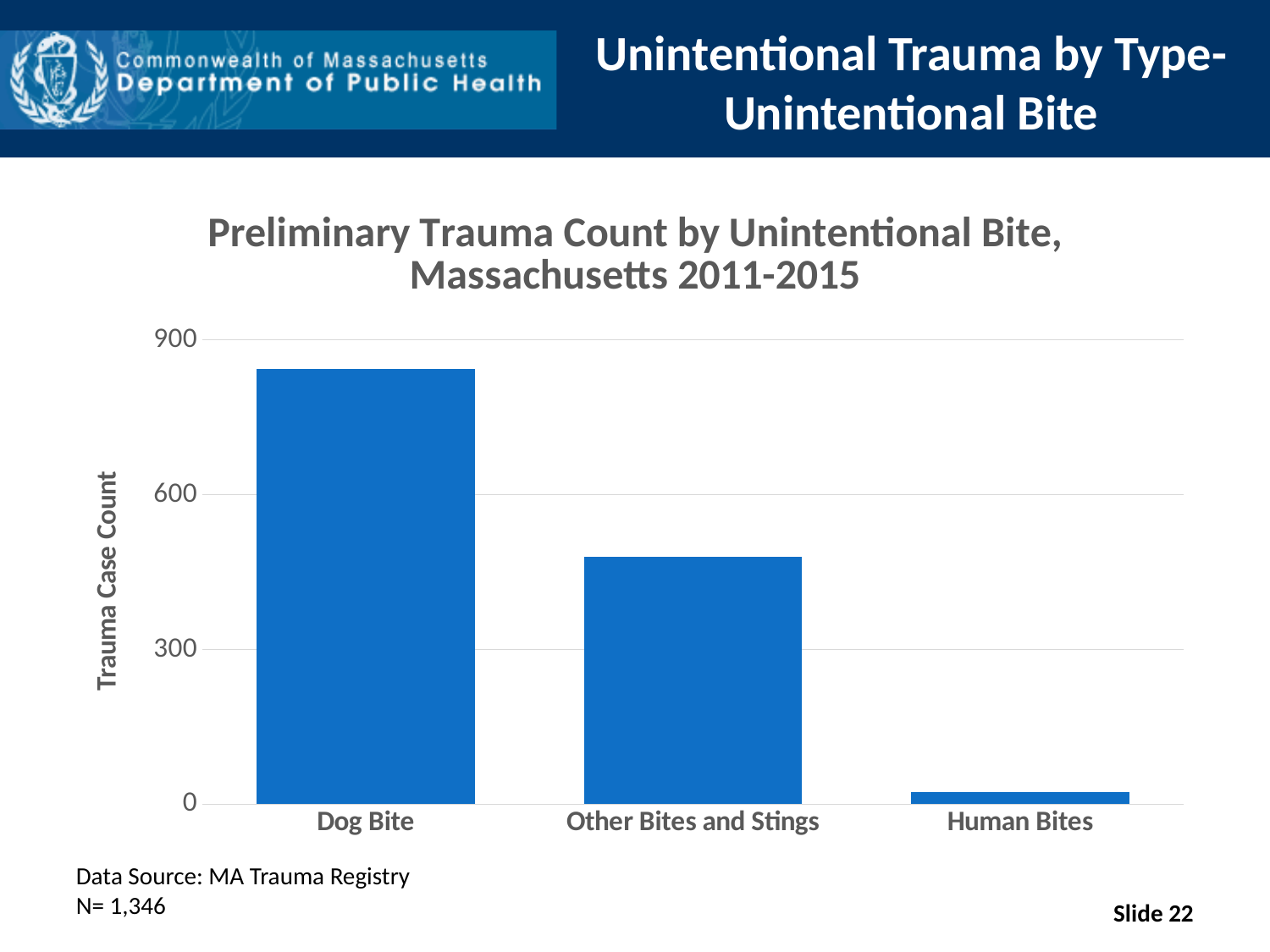
Which has a lower trauma case count, Other Bites and Stings or Human Bites? Human Bites Is the trauma case count for Human Bites greater or less than 300? less How many categories are shown on the chart? 3 Which category has the lowest trauma case count? Human Bites Is the trauma case count for Other Bites and Stings greater or less than 600? less Is the trauma case count for Dog Bite greater or less than 900? less Which has a higher trauma case count, Dog Bite or Other Bites and Stings? Dog Bite Which category has the highest trauma case count? Dog Bite What is the label of the vertical axis? Trauma Case Count What type of chart is shown on the slide? Bar chart